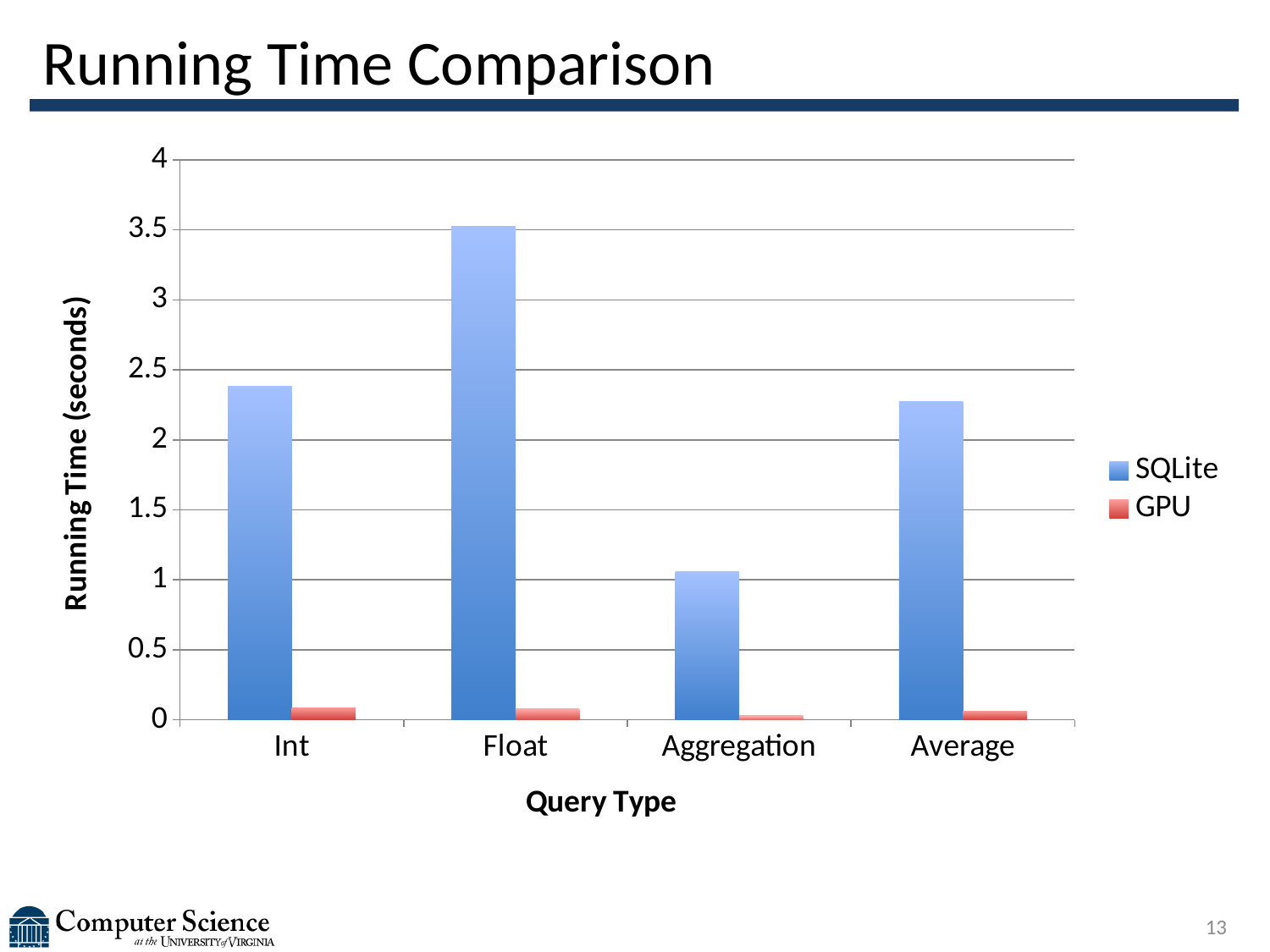
Which is larger, the SQLite running time for Int or for Float? Float How many query types are shown on the x axis? 4 Is the SQLite running time for Aggregation greater or less than 1.5? less For the Average query type, which series has the larger running time, SQLite or GPU? SQLite What is the label of the y axis? Running Time (seconds) Is the SQLite running time for Float greater or less than 3? greater What kind of chart is shown on the slide? bar chart Which query type has the lowest SQLite running time? Aggregation How many series does the legend list? 2 Is the SQLite running time for Int greater or less than 2? greater Which query type has the highest SQLite running time? Float